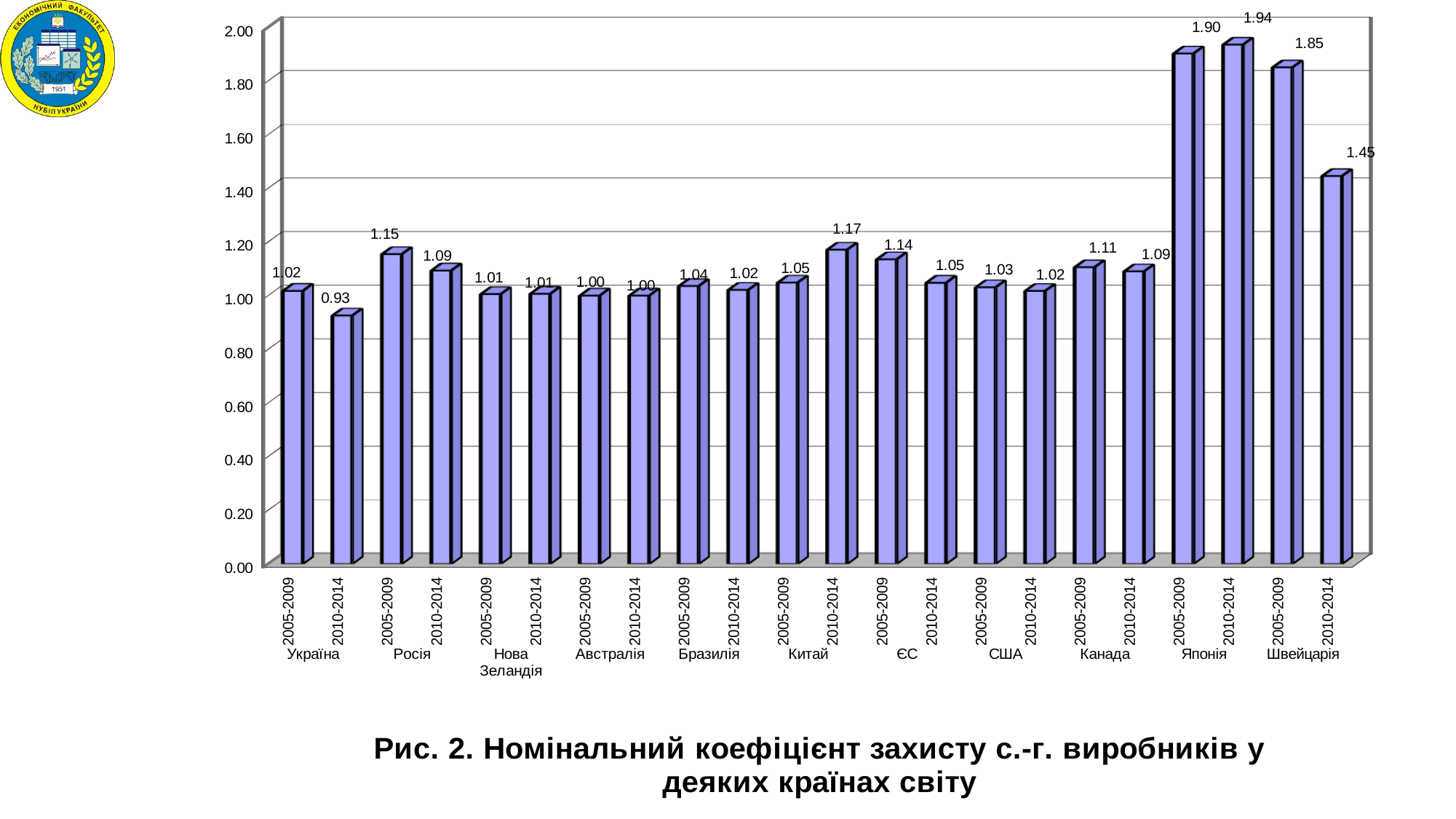
Which is larger: the value for Росія in 2005-2009 or the value for ЄС in 2005-2009? Росія 2005-2009 What is the value for Японія in 2010-2014? 1.94 What is the value for Україна in 2010-2014? 0.93 Which bar has the highest value on the chart? Японія 2010-2014 Is the value for Японія in 2005-2009 greater or less than 1.80? greater What is the value for Китай in 2005-2009? 1.05 What is the title of the figure shown on the slide? Рис. 2. Номінальний коефіцієнт захисту с.-г. виробників у деяких країнах світу What is the value for Швейцарія in 2010-2014? 1.45 What kind of chart is shown on the slide? bar chart What is the difference between the Швейцарія values for 2005-2009 and 2010-2014? 0.40 How many countries are shown on the x axis? 11 Which bar has the lowest value on the chart? Україна 2010-2014